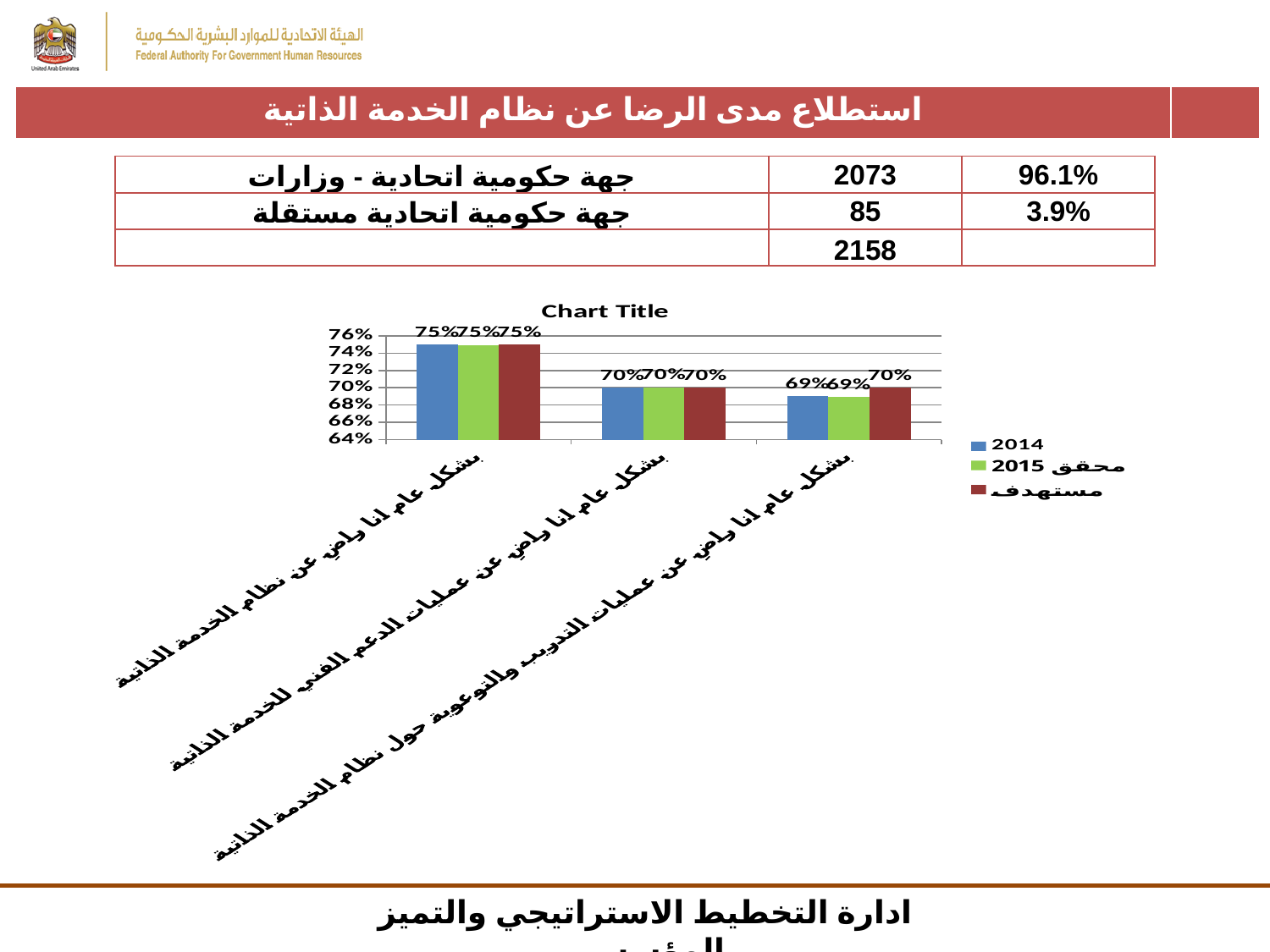
For the third category, what is the difference between the مستهدف value and the 2014 value? 1% What is the title shown above the chart? Chart Title What is the 2014 value for the first category (بشكل عام انا راضٍ عن نظام الخدمة الذاتية)? 75% Which category has the highest 2014 value? بشكل عام انا راضٍ عن نظام الخدمة الذاتية (the first category) What is the محقق 2015 value for the second category (بشكل عام انا راضٍ عن عمليات الدعم الفني للخدمة الذاتية)? 70% Which is larger: the 2014 value for the first category or the 2014 value for the second category? the first category How many categories are plotted along the x axis of the chart? 3 What is the difference between the 2014 value of the first category and the 2014 value of the third category? 6% What kind of chart is shown on the slide? bar chart Which category has the lowest محقق 2015 value? بشكل عام انا راضٍ عن عمليات التدريب والتوعوية حول نظام الخدمة الذاتية (the third category) How many series does the chart legend list? 3 What is the مستهدف value for the third category (بشكل عام انا راضٍ عن عمليات التدريب والتوعوية حول نظام الخدمة الذاتية)? 70%